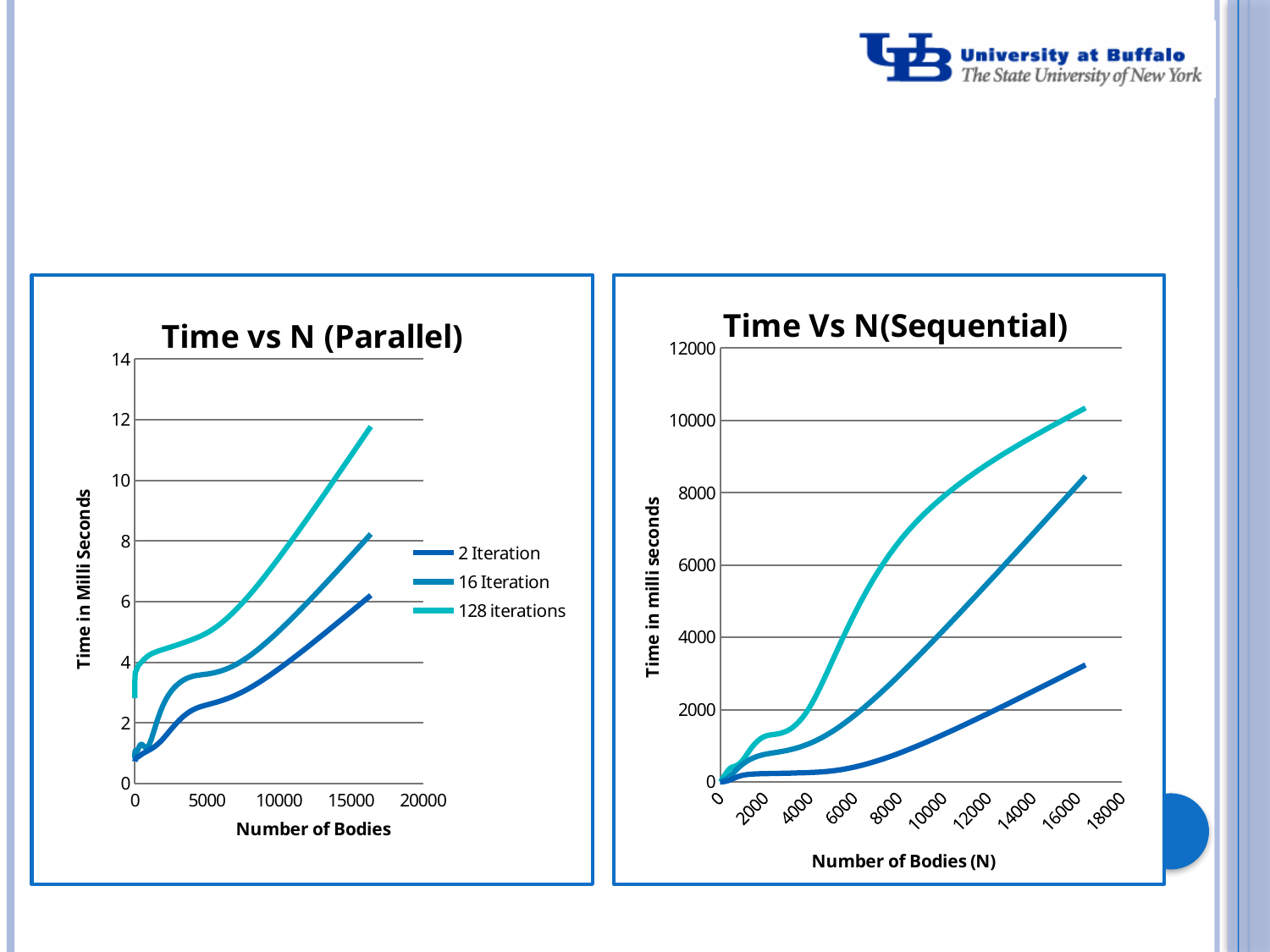
In the "Time Vs N(Sequential)" chart, do the plotted times rise or fall as the number of bodies increases? rise What is the y-axis label of the "Time Vs N(Sequential)" chart? Time in milli seconds In the "Time Vs N(Sequential)" chart, is the highest value reached by the top line greater or less than 10000? greater In the "Time vs N (Parallel)" chart, is the final value of the 128 iterations line greater or less than 10? greater In the "Time vs N (Parallel)" chart, is the final value of the 2 Iteration line greater or less than 4? greater How many series does the legend of the "Time vs N (Parallel)" chart list? 3 In the "Time vs N (Parallel)" chart, does the time for 128 iterations rise or fall as the number of bodies increases? rise In the "Time vs N (Parallel)" chart, which series has the highest time at the largest number of bodies plotted? 128 iterations How many lines are plotted on the "Time Vs N(Sequential)" chart? 3 In the "Time vs N (Parallel)" chart, which series has the lowest time at the largest number of bodies plotted? 2 Iteration What kind of chart is the "Time vs N (Parallel)" chart? line chart What kind of chart is the "Time Vs N(Sequential)" chart? line chart